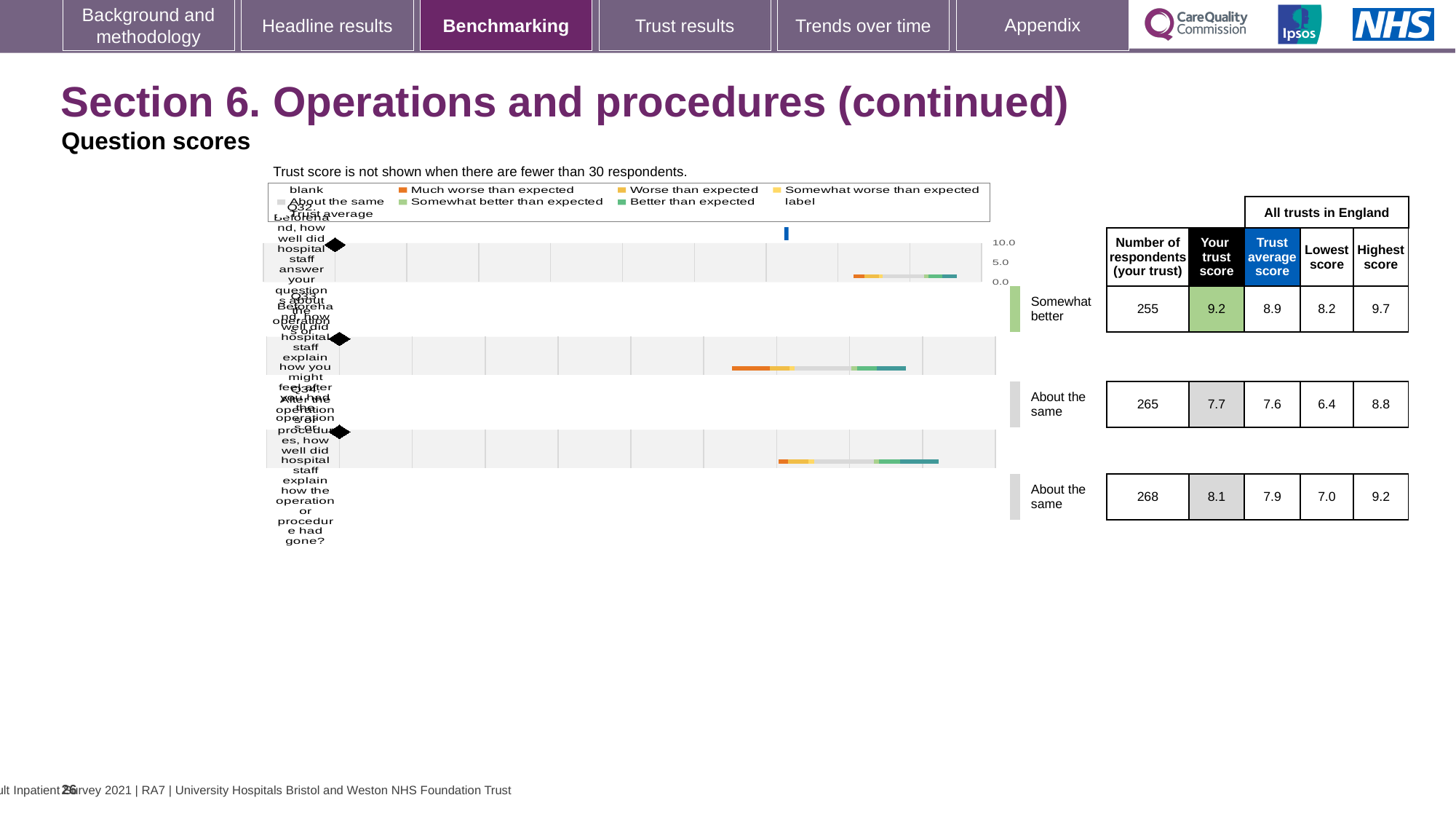
What is the highest value shown on the chart's axis? 10.0 Which question row has the highest 'Your trust score'? the first row (9.2) Is 'Your trust score' for the second question row larger or smaller than its 'Trust average score'? larger What is the 'Highest score' for the third question row? 9.2 How many question rows are plotted in the chart? 3 What is the 'Lowest score' for the second question row? 6.4 What is the 'Trust average score' for the second question row? 7.6 What is the 'Your trust score' for the first question row (Somewhat better)? 9.2 What is the difference between 'Your trust score' and 'Trust average score' for the third question row? 0.2 Which question row has the lowest 'Lowest score'? the second row (6.4) How many respondents does the third question row have? 268 What kind of chart is shown on the slide? bar chart